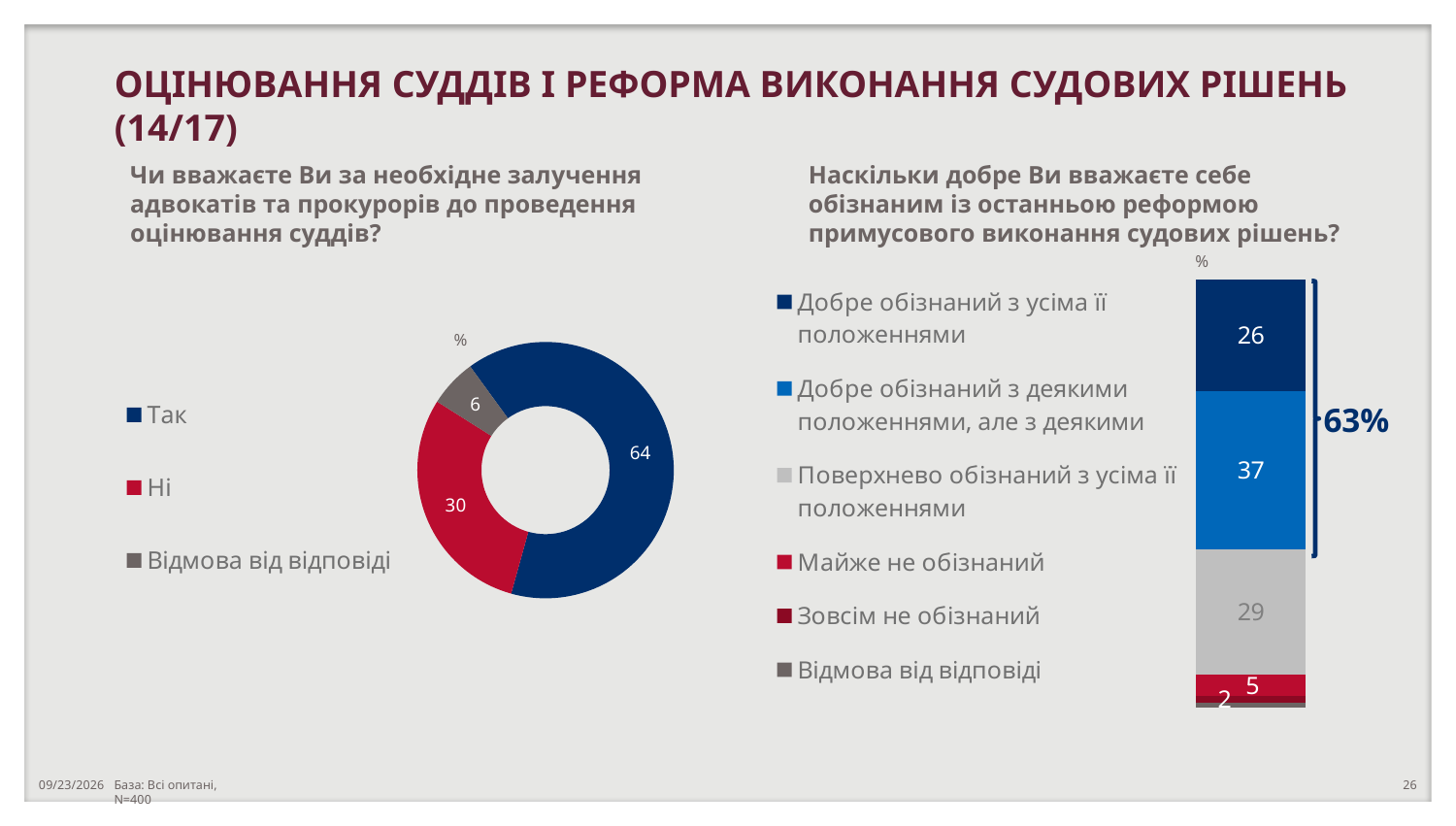
How many categories does the legend of the left chart list? 3 In the left chart, what is the value for "Відмова від відповіді"? 6 In the right chart, what is the value for "Поверхнево обізнаний з усіма її положеннями"? 29 What type of chart is the left chart? Donut (pie) chart In the left chart, what is the difference between "Так" and "Ні"? 34 In the right chart, which category has the highest value? Добре обізнаний з деякими положеннями, але з деякими In the right chart (Наскільки добре Ви вважаєте себе обізнаним із останньою реформою примусового виконання судових рішень?), what is the value for "Добре обізнаний з усіма її положеннями"? 26 In the right chart, what is the value for "Добре обізнаний з деякими положеннями, але з деякими"? 37 In the left chart (Чи вважаєте Ви за необхідне залучення адвокатів та прокурорів до проведення оцінювання суддів?), what percentage answered "Так"? 64 In the left chart, what is the value for "Ні"? 30 In the left chart, which category has the largest share? Так In the right chart, what combined percentage is highlighted by the bracket next to the top two segments? 63%